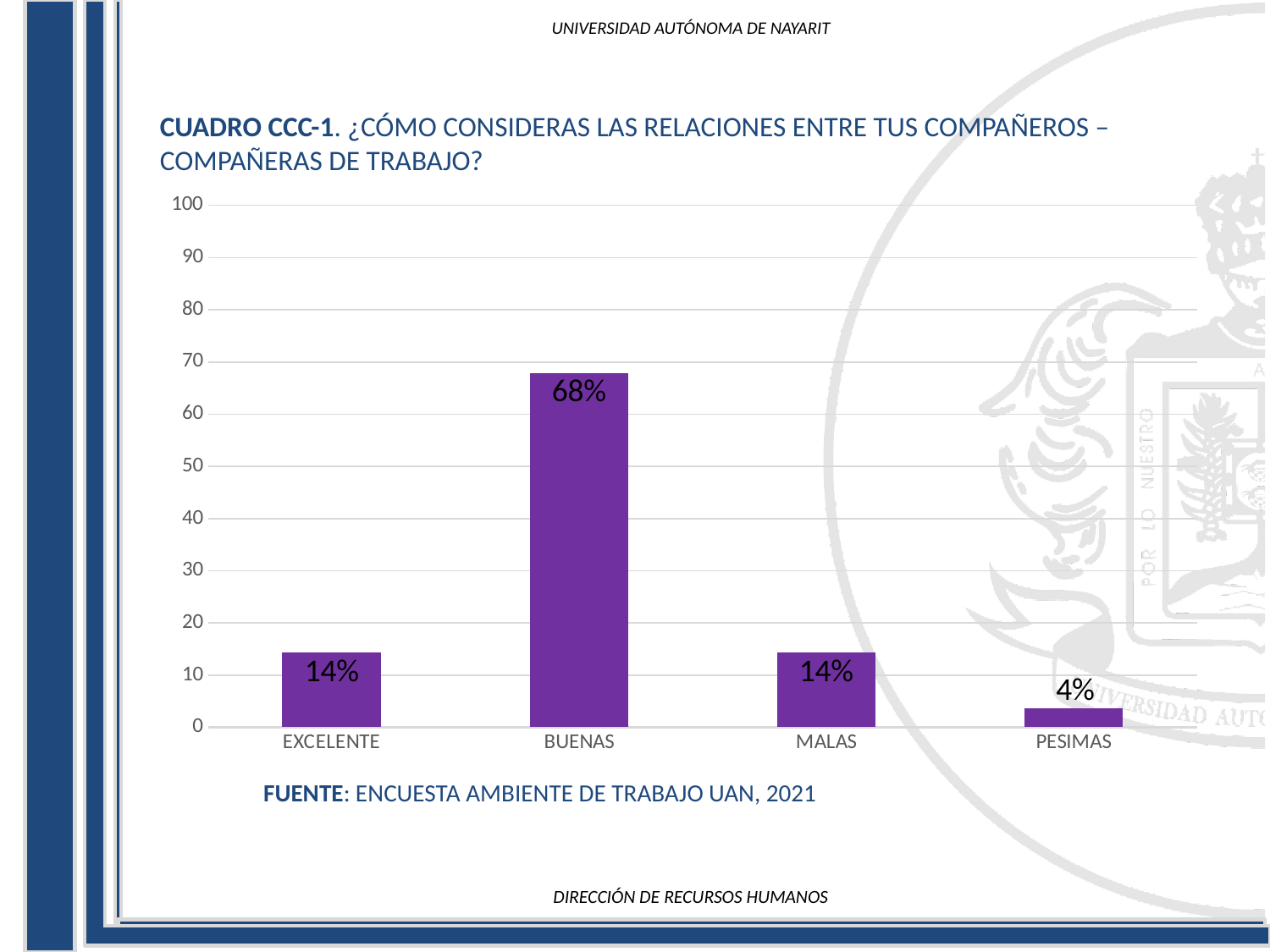
Which category has the lowest value? PESIMAS How many categories are shown on the x axis? 4 Which category has the highest value? BUENAS What is the value for EXCELENTE? 14% What is the value for BUENAS? 68% What colour are the bars in the chart? purple What is the difference between the values for BUENAS and MALAS? 54% What kind of chart is shown on the slide? bar chart Is the value for BUENAS greater or less than 60? greater Which is larger, the value for MALAS or the value for PESIMAS? MALAS What is the value for PESIMAS? 4% What is the source cited below the chart? ENCUESTA AMBIENTE DE TRABAJO UAN, 2021